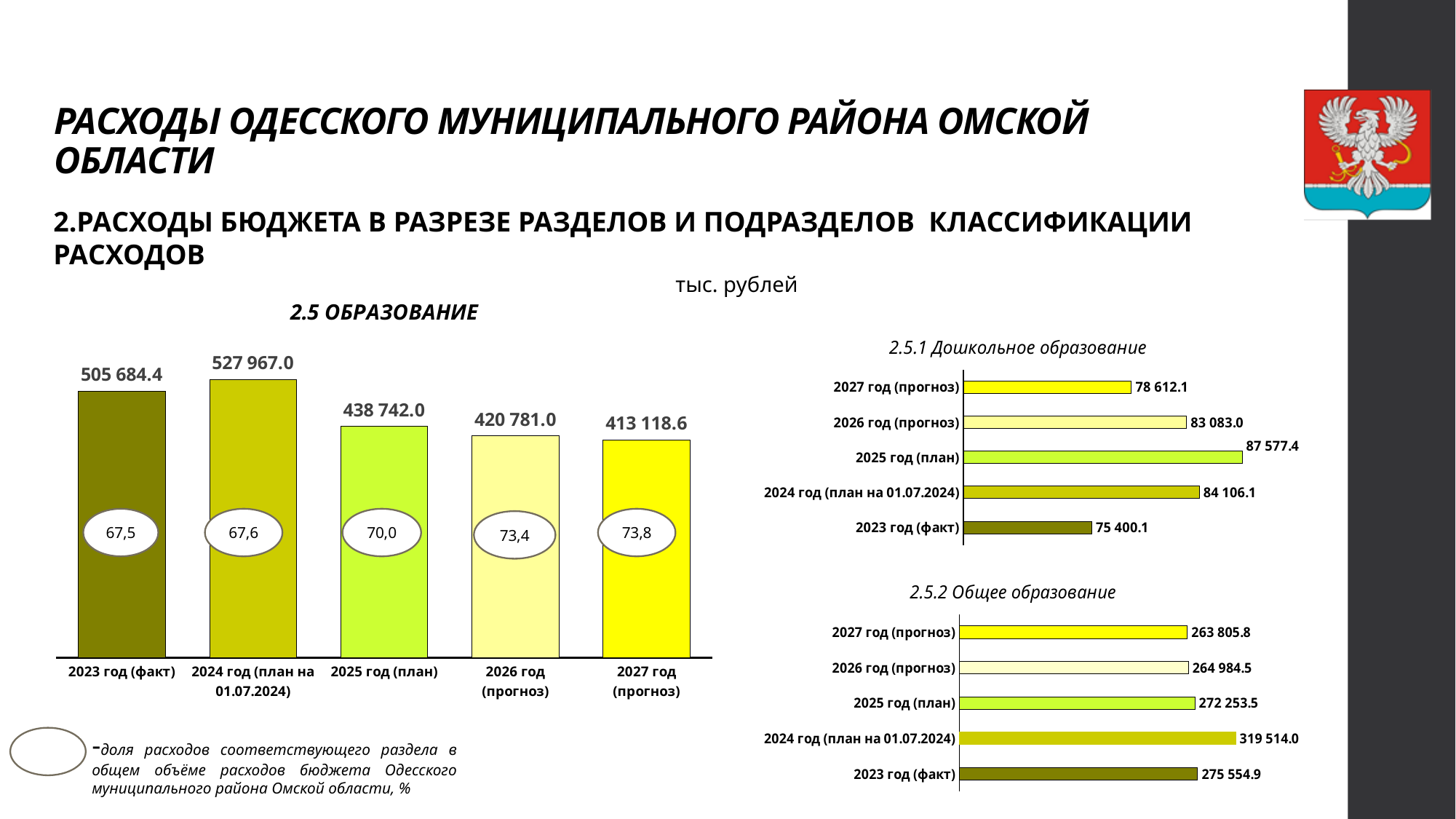
In the chart titled "2.5 ОБРАЗОВАНИЕ", what share percentage is shown in the circle on the 2026 год (прогноз) bar? 73,4 In the chart titled "2.5.1 Дошкольное образование", what is the value for 2025 год (план)? 87 577.4 In the chart titled "2.5 ОБРАЗОВАНИЕ", how many bars are plotted? 5 In the chart titled "2.5.2 Общее образование", what is the value for 2024 год (план на 01.07.2024)? 319 514.0 In the chart titled "2.5 ОБРАЗОВАНИЕ", which category has the lowest value? 2027 год (прогноз) What kind of chart is "2.5.1 Дошкольное образование"? Bar chart In the chart titled "2.5.1 Дошкольное образование", which category has the highest value? 2025 год (план) In the chart titled "2.5 ОБРАЗОВАНИЕ", what is the value for 2024 год (план на 01.07.2024)? 527 967.0 In the chart titled "2.5.1 Дошкольное образование", which is larger: the value for 2026 год (прогноз) or 2027 год (прогноз)? 2026 год (прогноз) In the chart titled "2.5.2 Общее образование", what is the difference between the values for 2023 год (факт) and 2025 год (план)? 3 301.4 In the chart titled "2.5.2 Общее образование", which category has the lowest value? 2027 год (прогноз) In the chart titled "2.5 ОБРАЗОВАНИЕ", what is the difference between the values for 2023 год (факт) and 2027 год (прогноз)? 92 565.8